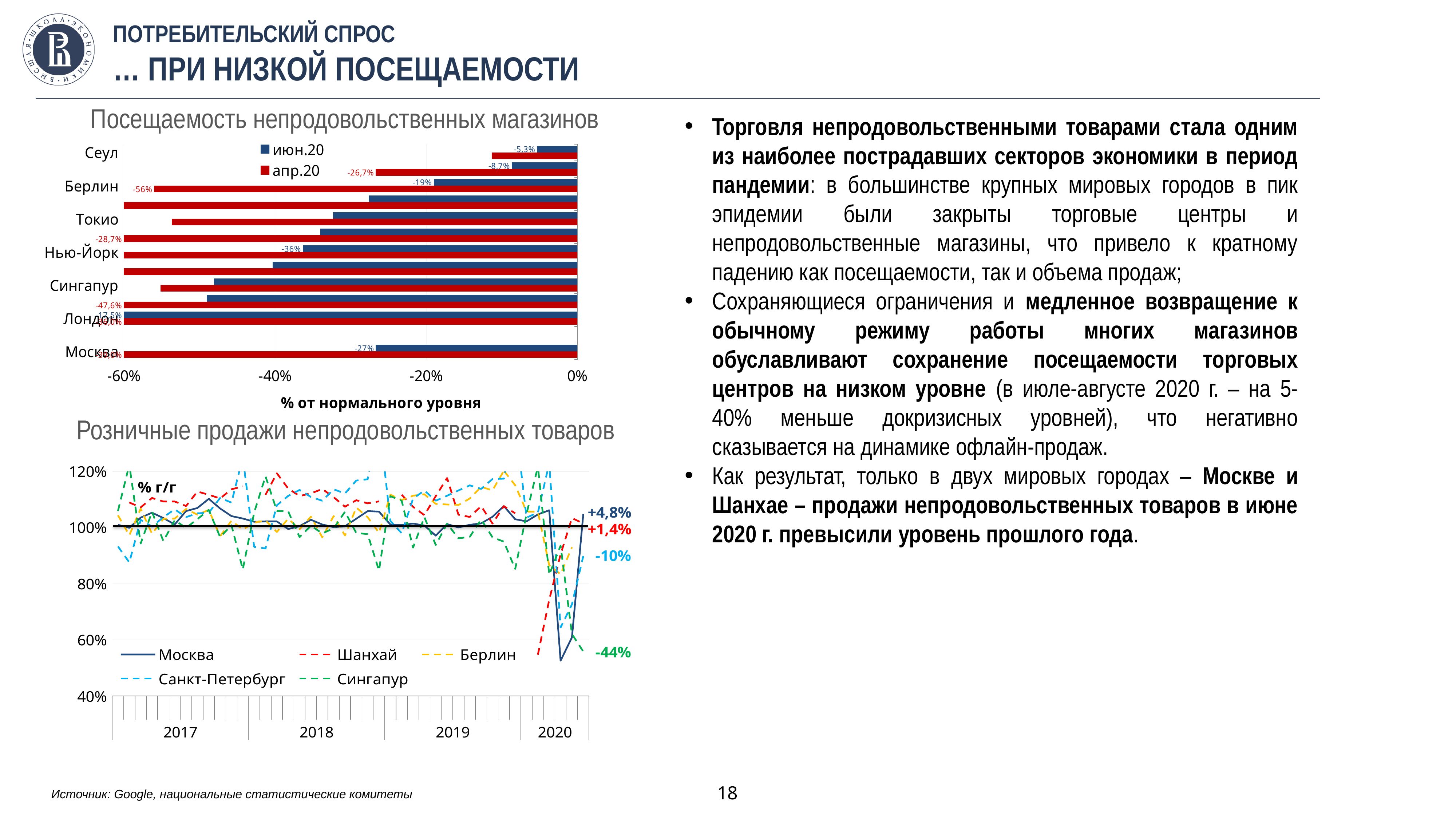
In the top chart "Посещаемость непродовольственных магазинов", what is the value for Берлин in апр.20? -56% In the top chart "Посещаемость непродовольственных магазинов", what is the value for Москва in июн.20? -27% What kind of chart is the bottom chart titled "Розничные продажи непродовольственных товаров"? Line chart In the top chart "Посещаемость непродовольственных магазинов", how many series does the legend list? 2 In the top chart "Посещаемость непродовольственных магазинов", what is the value for Сеул in июн.20? -5,3% In the bottom chart "Розничные продажи непродовольственных товаров", what is the latest labelled value for Москва? +4,8% In the bottom chart "Розничные продажи непродовольственных товаров", which series has the lowest labelled end value? Сингапур In the top chart "Посещаемость непродовольственных магазинов", what is the value for Берлин in июн.20? -19% In the bottom chart "Розничные продажи непродовольственных товаров", what is the latest labelled value for Сингапур? -44% In the bottom chart "Розничные продажи непродовольственных товаров", how many series does the legend list? 5 What kind of chart is the top chart titled "Посещаемость непродовольственных магазинов"? Bar chart In the top chart "Посещаемость непродовольственных магазинов", which series is shown in red? апр.20